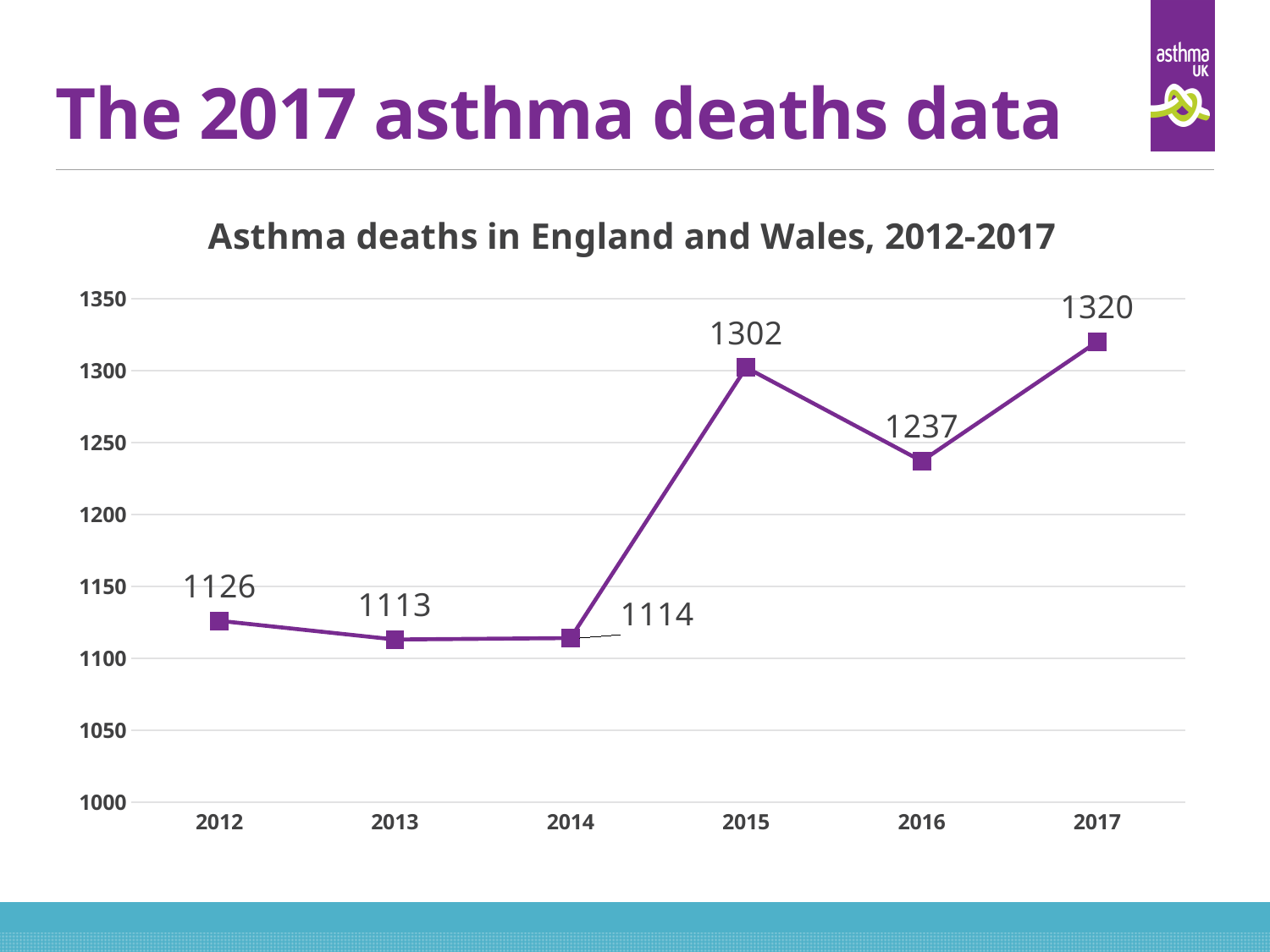
Which year has the highest number of asthma deaths? 2017 What is the difference between the values for 2017 and 2012? 194 Which year has the lowest number of asthma deaths? 2013 What is the value for 2013? 1113 What kind of chart is shown on the slide? line chart How many years are plotted on the chart? 6 What is the title of the chart? Asthma deaths in England and Wales, 2012-2017 What is the value for 2017? 1320 Which is larger, the value for 2015 or the value for 2016? 2015 What is the value for 2015? 1302 What is the difference between the values for 2015 and 2016? 65 Is the value for 2014 greater or less than 1150? less